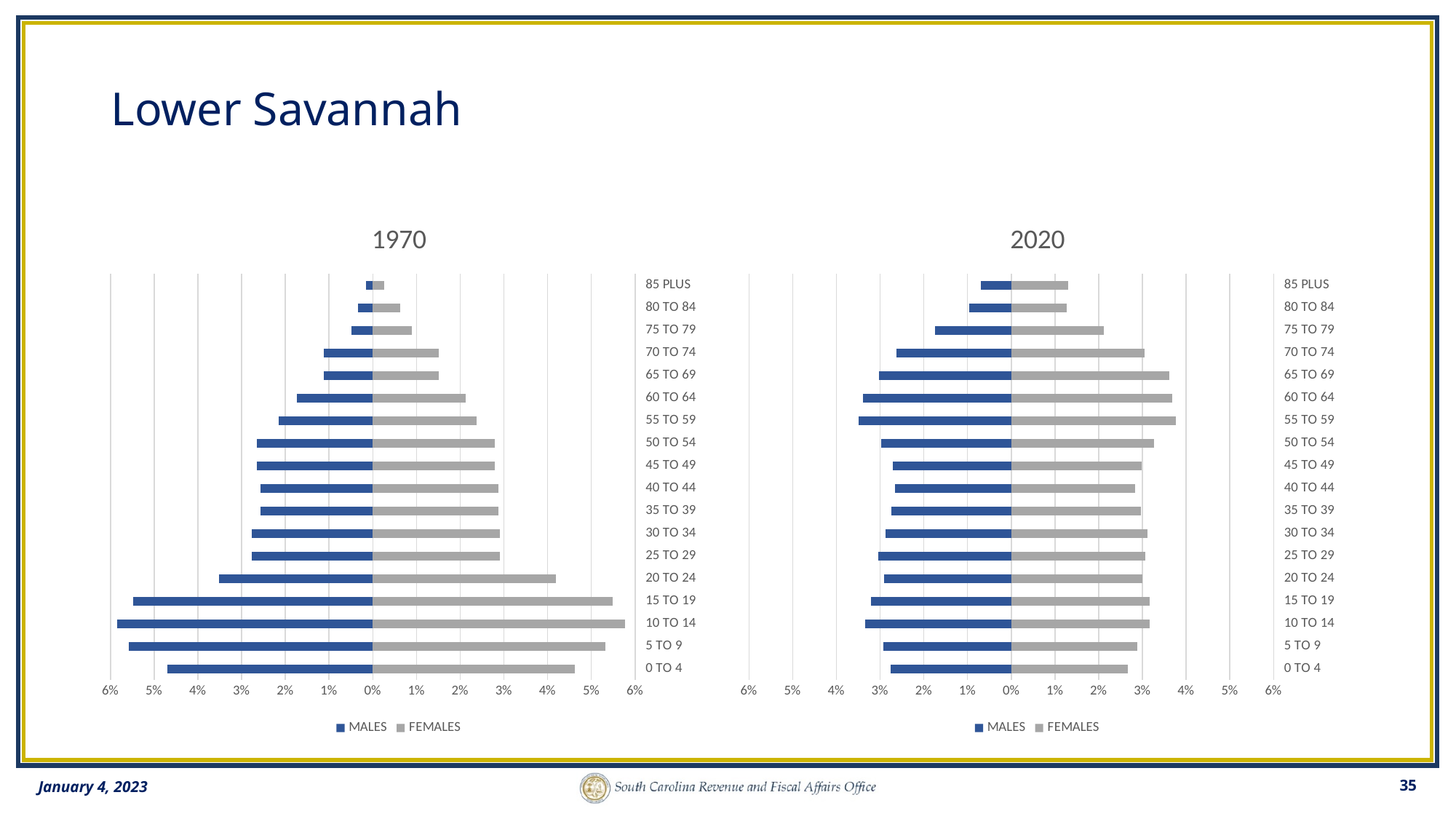
In the 1970 chart, which age group has the longest MALES bar? 10 TO 14 In the 1970 chart, is the MALES value for 10 TO 14 greater or less than 5%? greater Which chart shows a larger FEMALES value for 85 PLUS, the 1970 chart or the 2020 chart? 2020 What kind of chart is the 1970 chart? bar chart In the 1970 chart, which age group has the shortest FEMALES bar? 85 PLUS How many age-group categories does the 2020 chart show? 18 What are the two legend entries in the 2020 chart? MALES and FEMALES In the 1970 chart, which is larger: the MALES value for 0 TO 4 or for 20 TO 24? 0 TO 4 In the 2020 chart, which age group has the shortest MALES bar? 85 PLUS How many series does the legend of the 1970 chart list? 2 In the 2020 chart, is the MALES value for 85 PLUS greater or less than 1%? less In the 2020 chart, is the FEMALES value for 65 TO 69 greater or less than 3%? greater